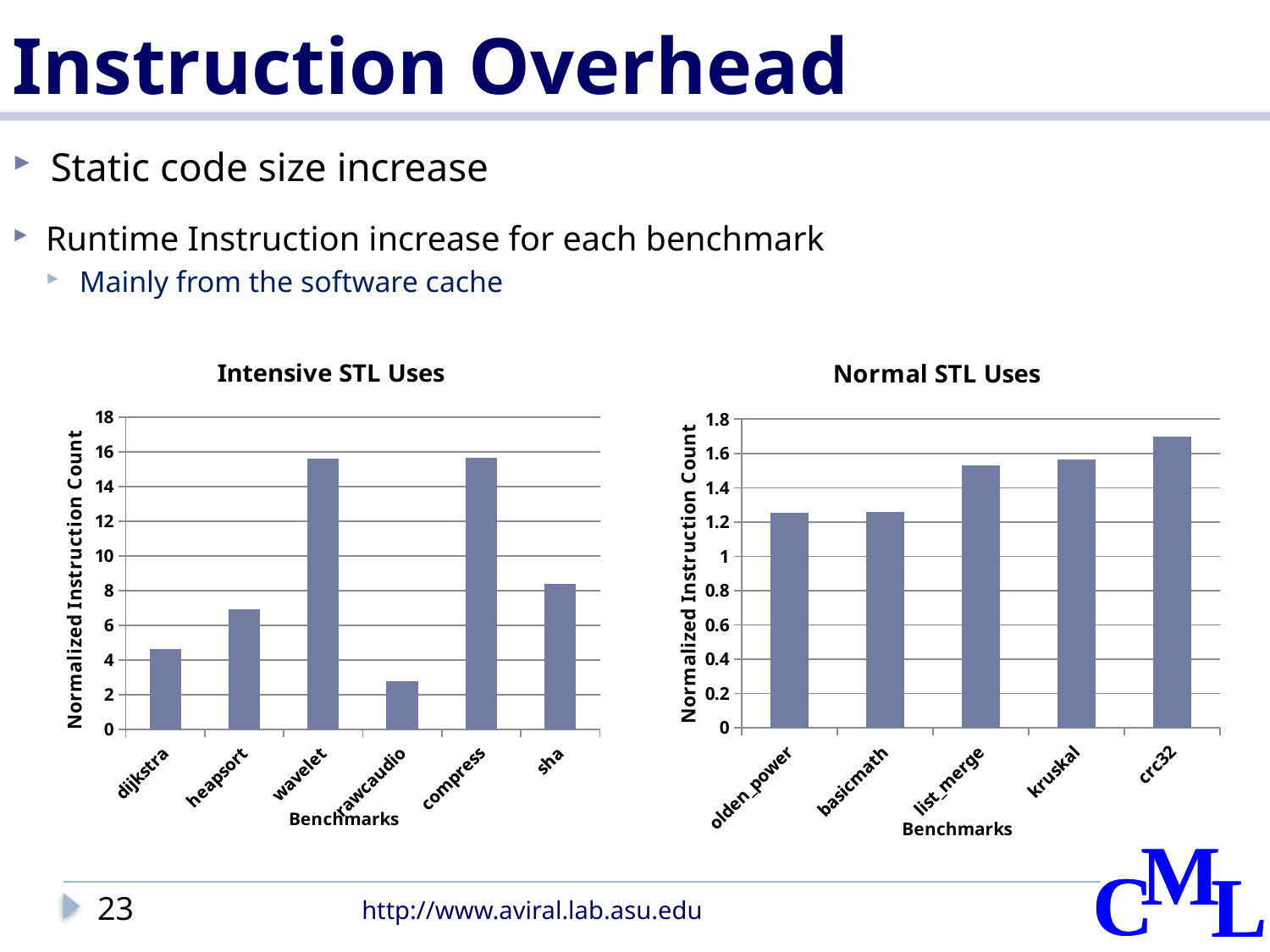
In the Intensive STL Uses chart, which benchmark has the lowest normalized instruction count? rawcaudio How many benchmarks are shown in the Normal STL Uses chart? 5 In the Intensive STL Uses chart, is the value for dijkstra greater or less than 6? less In the Normal STL Uses chart, which benchmark has the highest normalized instruction count? crc32 In the Intensive STL Uses chart, which is larger, the value for wavelet or the value for heapsort? wavelet In the Intensive STL Uses chart, is the value for rawcaudio greater or less than 4? less In the Normal STL Uses chart, is the value for crc32 greater or less than 1.6? greater In the Normal STL Uses chart, which is larger, the value for crc32 or the value for basicmath? crc32 What kind of chart is the Normal STL Uses chart? Bar chart How many benchmarks are shown in the Intensive STL Uses chart? 6